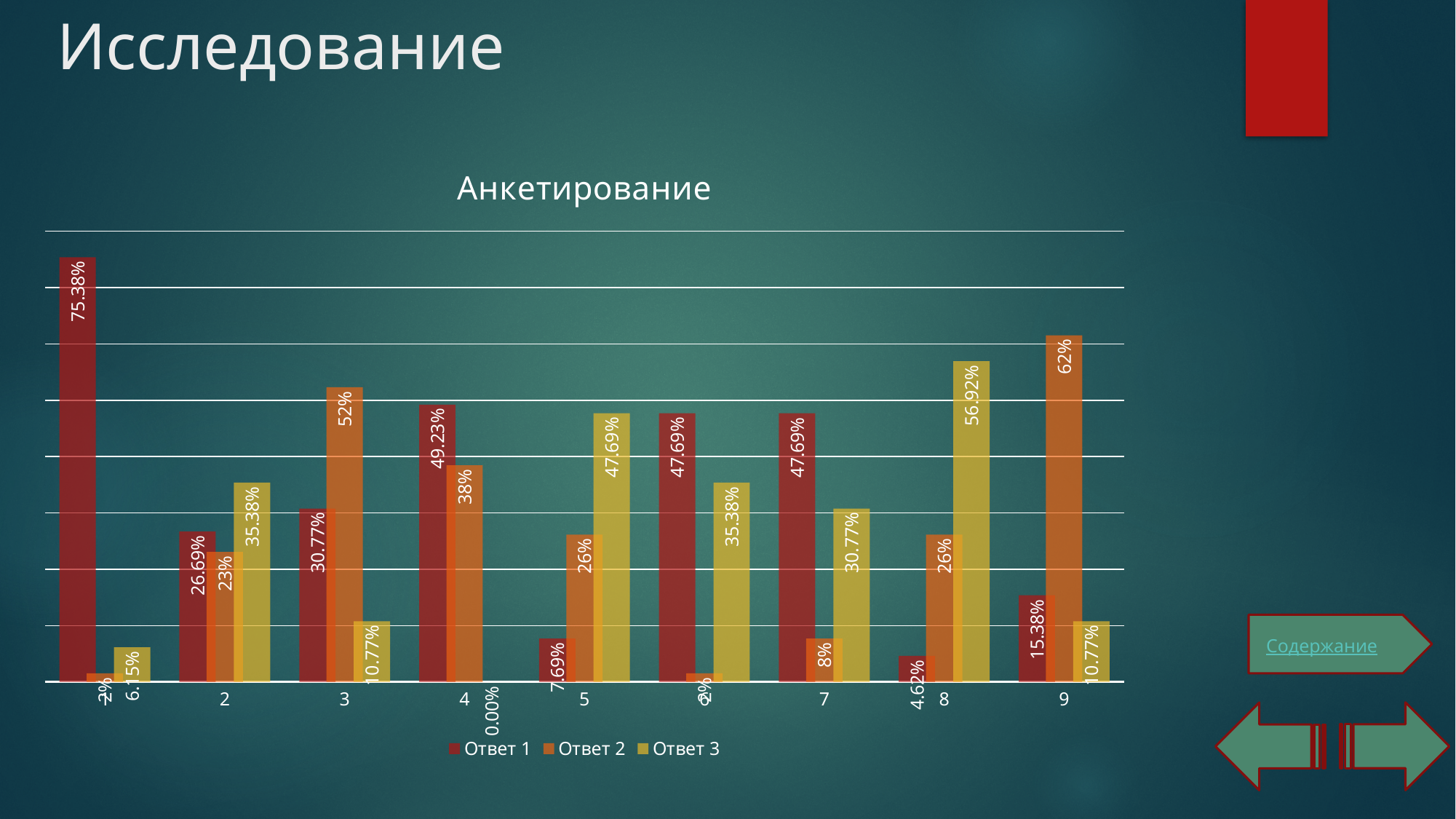
In category 3, how much larger is Ответ 2 than Ответ 1? 21.23% What is the value of Ответ 2 for category 9? 62% In category 5, which is larger: Ответ 2 or Ответ 3? Ответ 3 What kind of chart is shown on the slide? bar chart Which category has the highest value for Ответ 2? 9 Which category has the highest value for Ответ 1? 1 What is the value of Ответ 1 for category 1? 75.38% Which category has the lowest value for Ответ 3? 4 What is the value of Ответ 3 for category 4? 0.00% How many categories are shown on the x axis of the chart? 9 What is the value of Ответ 3 for category 8? 56.92% How many series does the legend of the chart list? 3